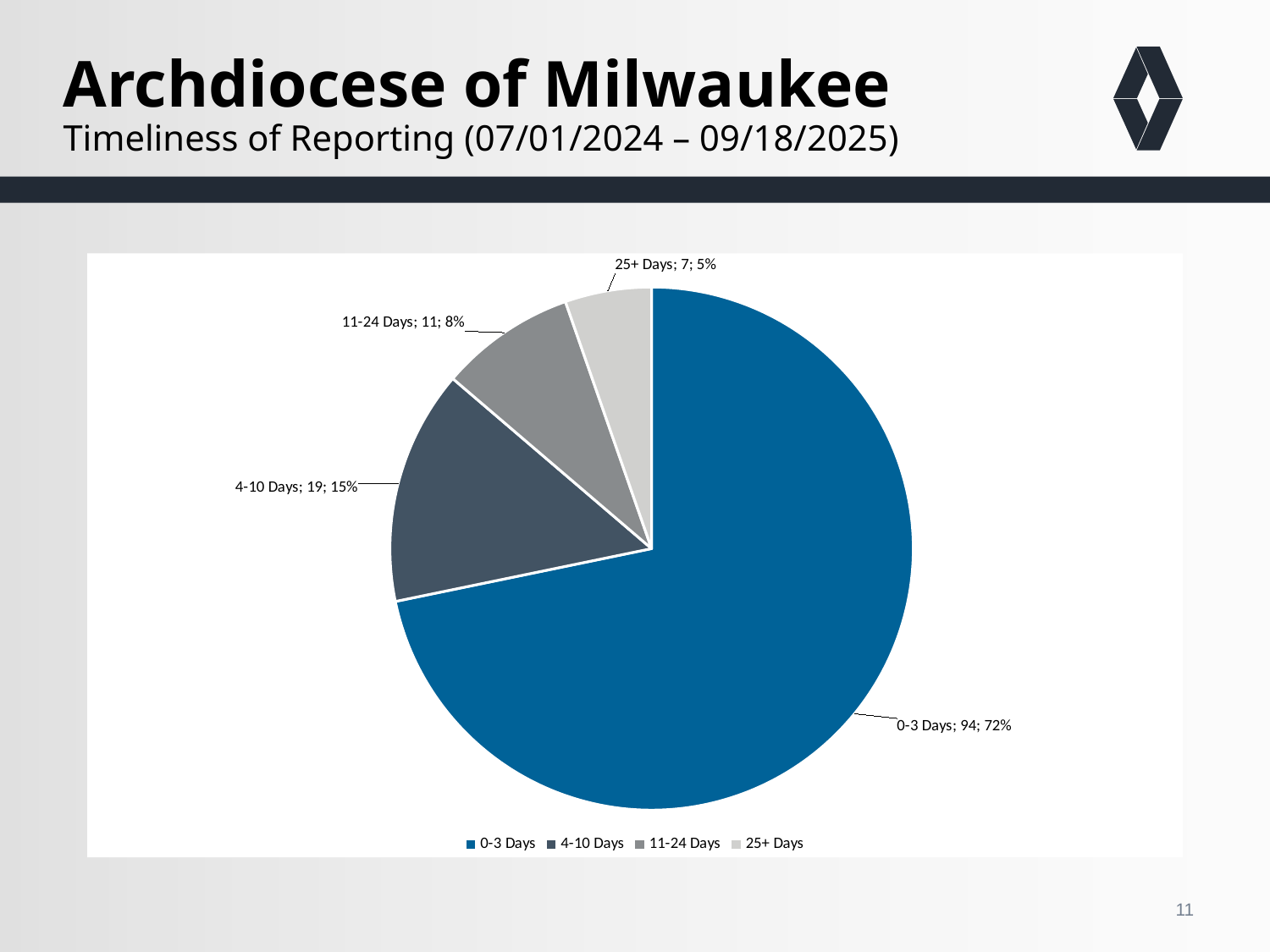
How many reports fall in the 0-3 Days category? 94 What type of chart is shown on the slide? Pie chart How many reports fall in the 11-24 Days category? 11 How many categories are shown in the pie chart? 4 What is the total number of reports across all four categories? 131 Which category has the smallest slice of the pie? 25+ Days Which category has the largest slice of the pie? 0-3 Days Which category has more reports, 11-24 Days or 25+ Days? 11-24 Days What is the difference in count between the 4-10 Days and 11-24 Days categories? 8 What colour is the 0-3 Days slice? Blue What percentage share does the 25+ Days slice represent? 5% What percentage share does the 4-10 Days slice represent? 15%